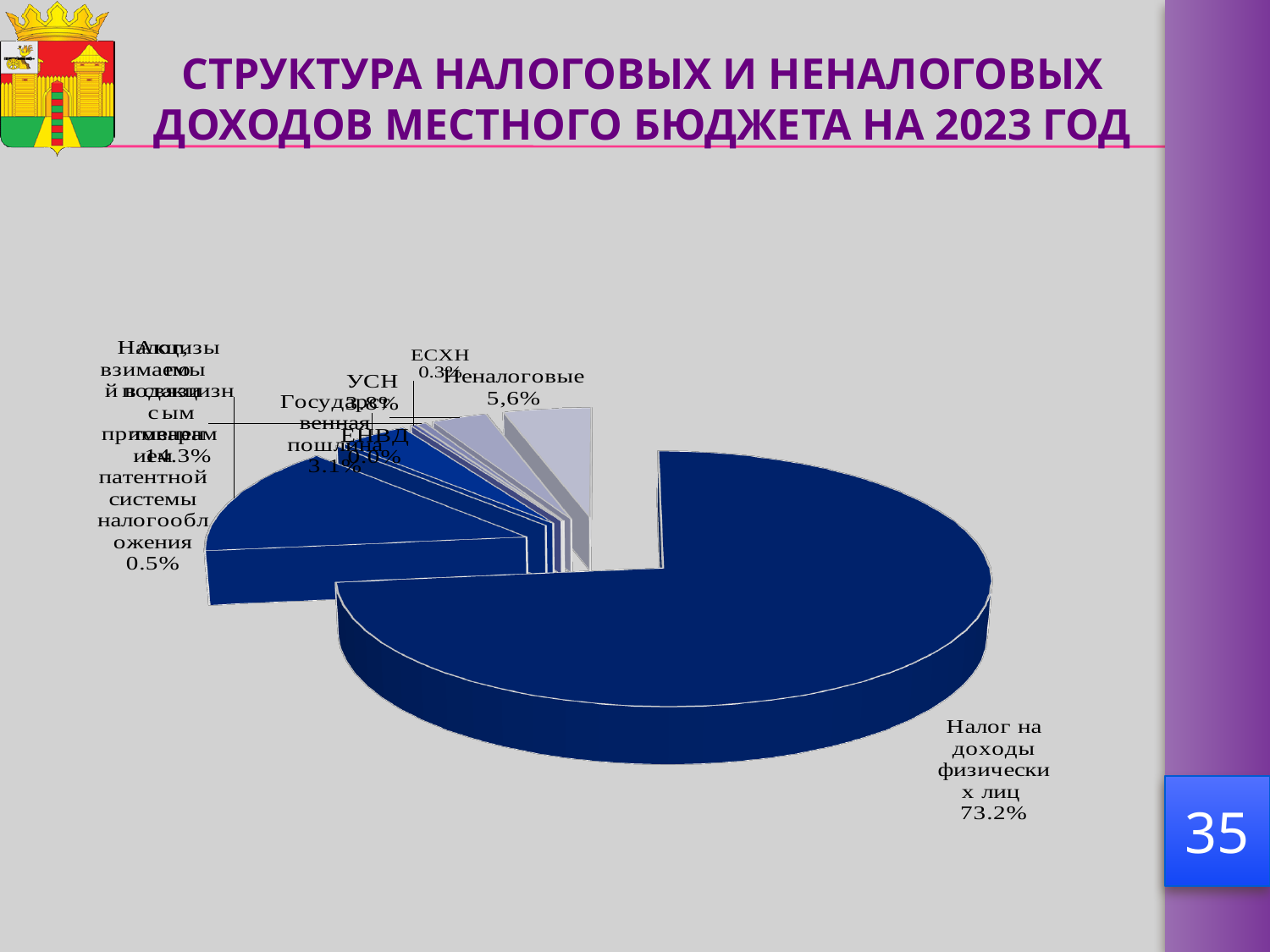
What is the title of the slide containing the chart? СТРУКТУРА НАЛОГОВЫХ И НЕНАЛОГОВЫХ ДОХОДОВ МЕСТНОГО БЮДЖЕТА НА 2023 ГОД What is the value shown for Неналоговые? 5,6% What is the value shown for Акцизы? 14.3% What is the value shown for ЕНВД? 0.0% What is the value shown for Государственная пошлина? 3.1% What share of the pie does Налог на доходы физических лиц have? 73.2% What kind of chart is shown on the slide? pie chart What is the difference between the share of Налог на доходы физических лиц and Неналоговые? 67.6% Which category has the smallest value in the chart? ЕНВД Which is larger, Акцизы or Неналоговые? Акцизы What is the value shown for ЕСХН? 0.3% Which category has the largest share of the pie? Налог на доходы физических лиц